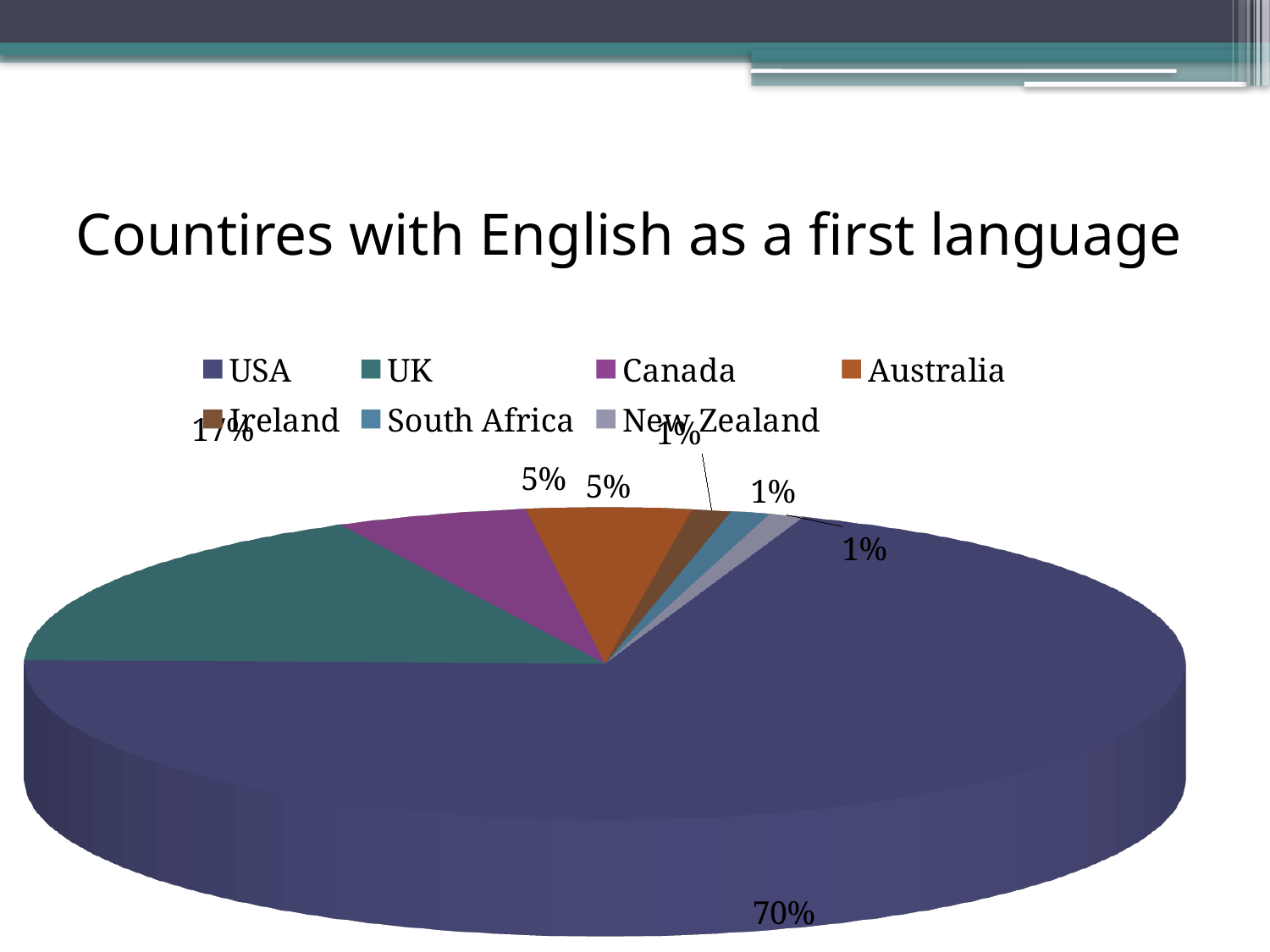
Which country has the largest slice of the pie? USA What is the value shown for Canada? 5% How many countries (slices) does the pie chart show? 7 What is the difference between the USA's share and Canada's share? 65% What is the value shown for Ireland? 1% What kind of chart is shown on the slide? pie chart What share of the pie does the USA have? 70% What is the title of the chart? Countires with English as a first language What is the value shown for Australia? 5% What is the value shown for the UK? 17% Which is larger, the slice for the UK or the slice for Canada? UK How many entries does the legend list? 7